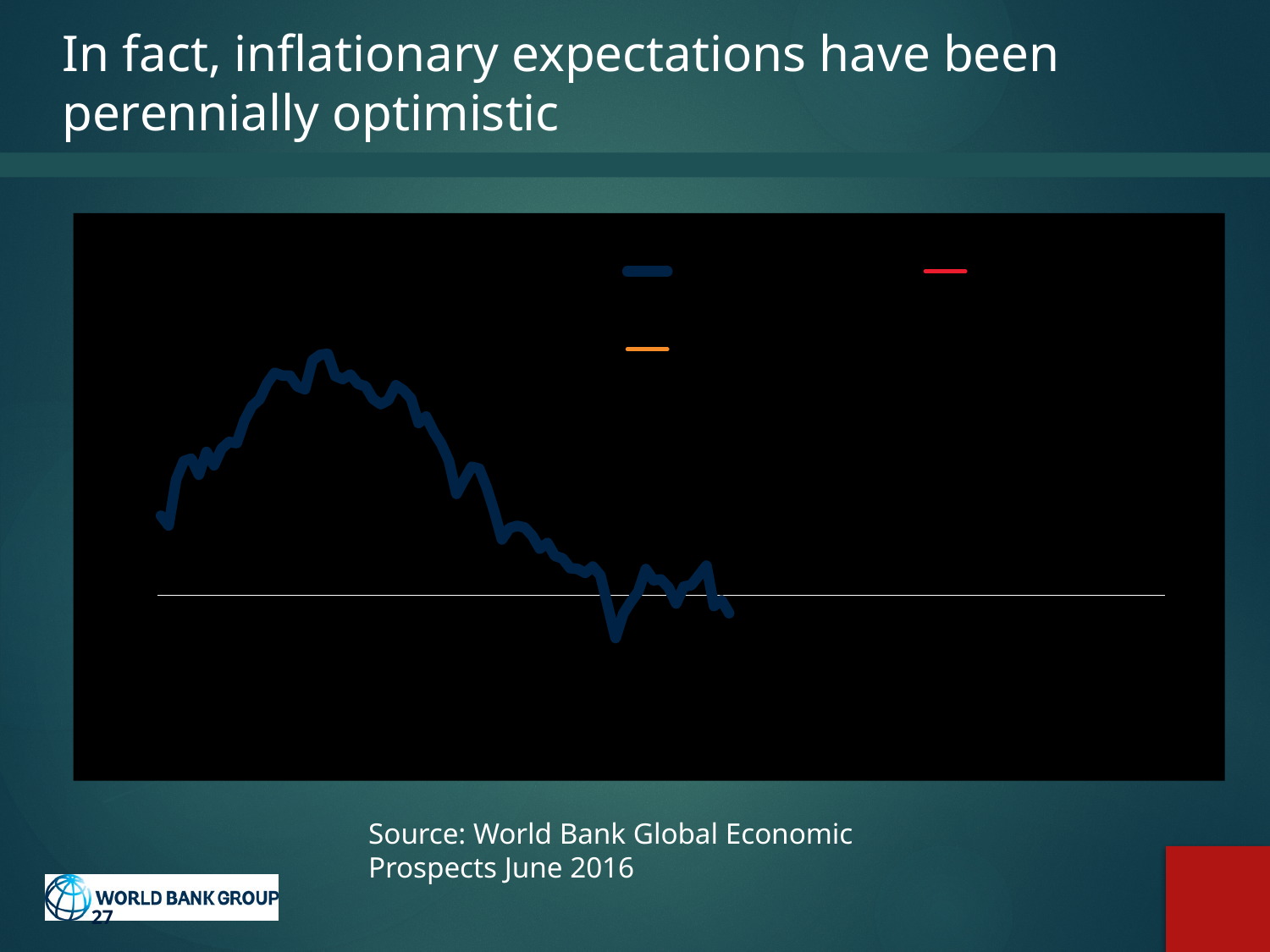
What colour is the line plotted in the chart? dark blue What kind of chart is shown on the slide? line chart Does the plotted blue line end higher or lower than where it starts on the left? lower Does the plotted blue line dip below the horizontal reference line near its right end? yes How many legend markers are shown in the chart? 3 Over the right half of the plotted blue line, do the values rise or fall? fall